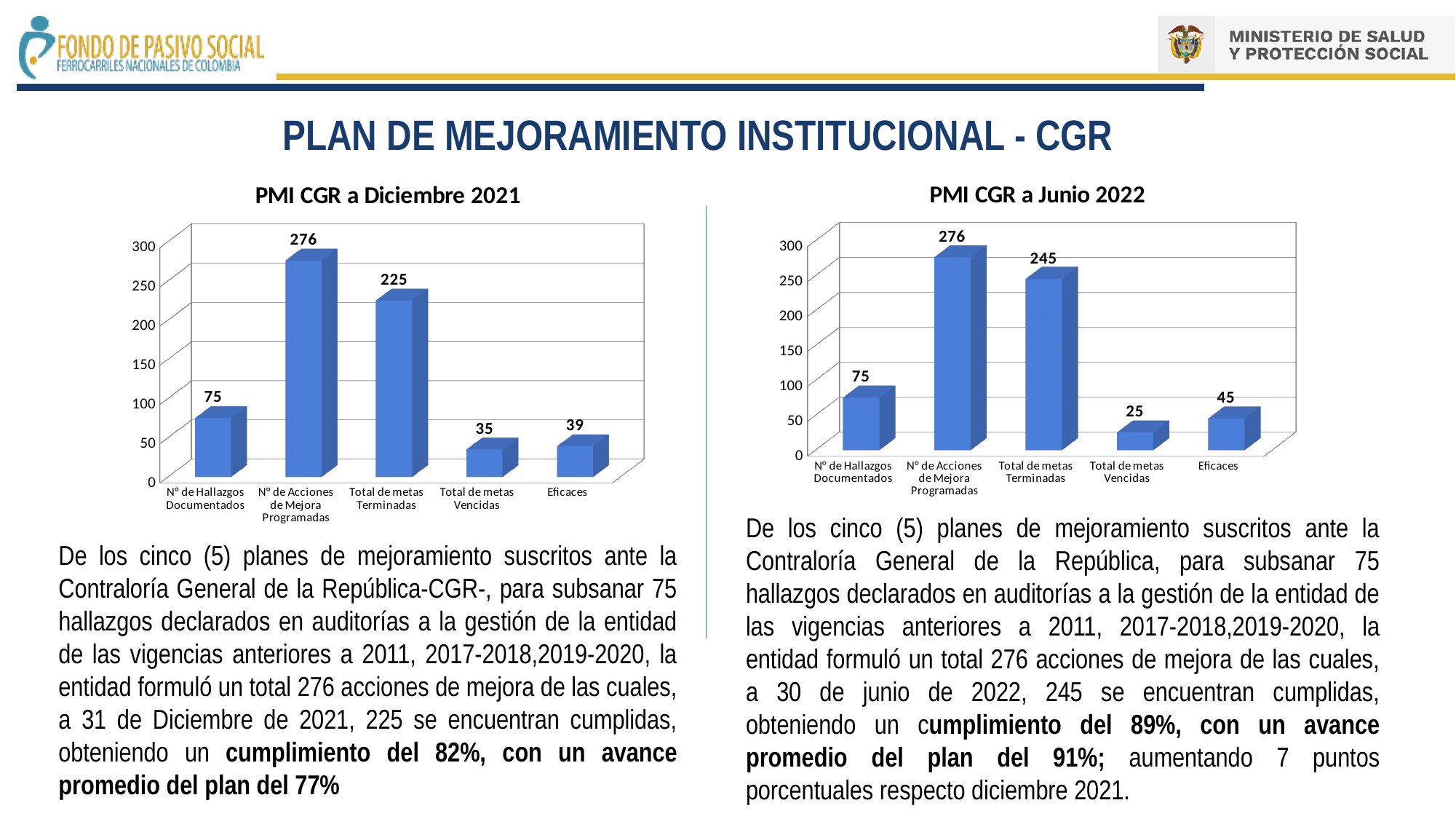
In the 'PMI CGR a Junio 2022' chart, is the value for N° de Hallazgos Documentados greater or less than 100? less In the 'PMI CGR a Diciembre 2021' chart, which is larger: Total de metas Vencidas or Eficaces? Eficaces In the 'PMI CGR a Junio 2022' chart, what is the value for Total de metas Terminadas? 245 How many categories are shown in the 'PMI CGR a Junio 2022' chart? 5 In the 'PMI CGR a Diciembre 2021' chart, what is the difference between N° de Acciones de Mejora Programadas and Total de metas Terminadas? 51 In the 'PMI CGR a Diciembre 2021' chart, what is the value for Eficaces? 39 In the 'PMI CGR a Junio 2022' chart, what is the value for Total de metas Vencidas? 25 In the 'PMI CGR a Diciembre 2021' chart, which category has the highest value? N° de Acciones de Mejora Programadas What type of chart is 'PMI CGR a Diciembre 2021'? Bar chart In the 'PMI CGR a Junio 2022' chart, which category has the lowest value? Total de metas Vencidas In the 'PMI CGR a Diciembre 2021' chart, what is the value for Total de metas Terminadas? 225 In the 'PMI CGR a Junio 2022' chart, what is the difference between Eficaces and Total de metas Vencidas? 20